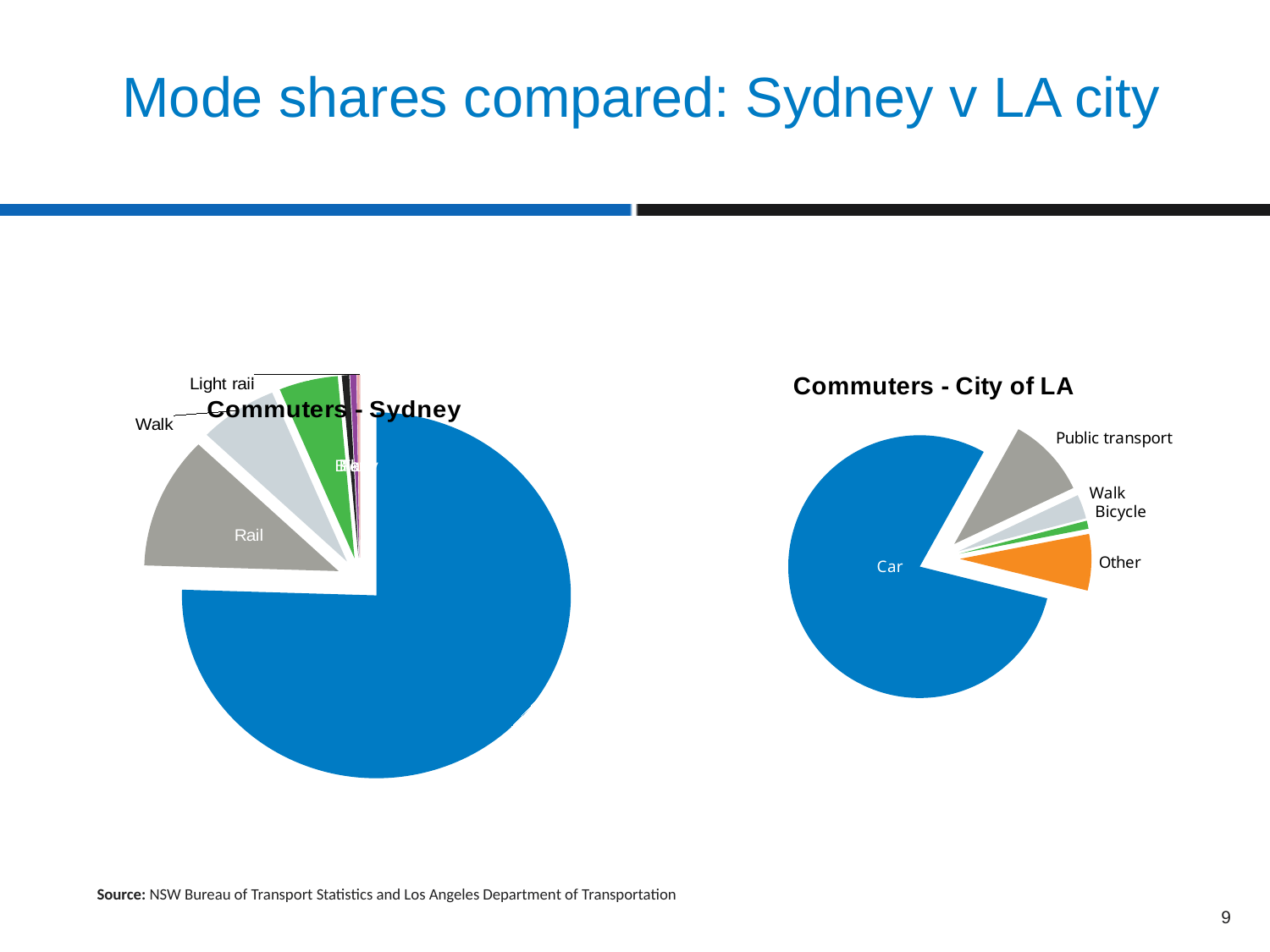
In the "Commuters - City of LA" chart, which is larger: Other or Bicycle? Other In the "Commuters - City of LA" chart, which mode has the largest share? Car What is the title of the pie chart on the right of the slide? Commuters - City of LA What is the title of the pie chart on the left of the slide? Commuters - Sydney In the "Commuters - Sydney" chart, which is larger: Rail or Walk? Rail How many labelled slices does the "Commuters - City of LA" chart have? 5 What kind of chart is the "Commuters - City of LA" chart? pie chart In the "Commuters - City of LA" chart, which labelled mode has the smallest share? Bicycle In the "Commuters - City of LA" chart, which is larger: Public transport or Walk? Public transport What kind of chart is the "Commuters - Sydney" chart? pie chart